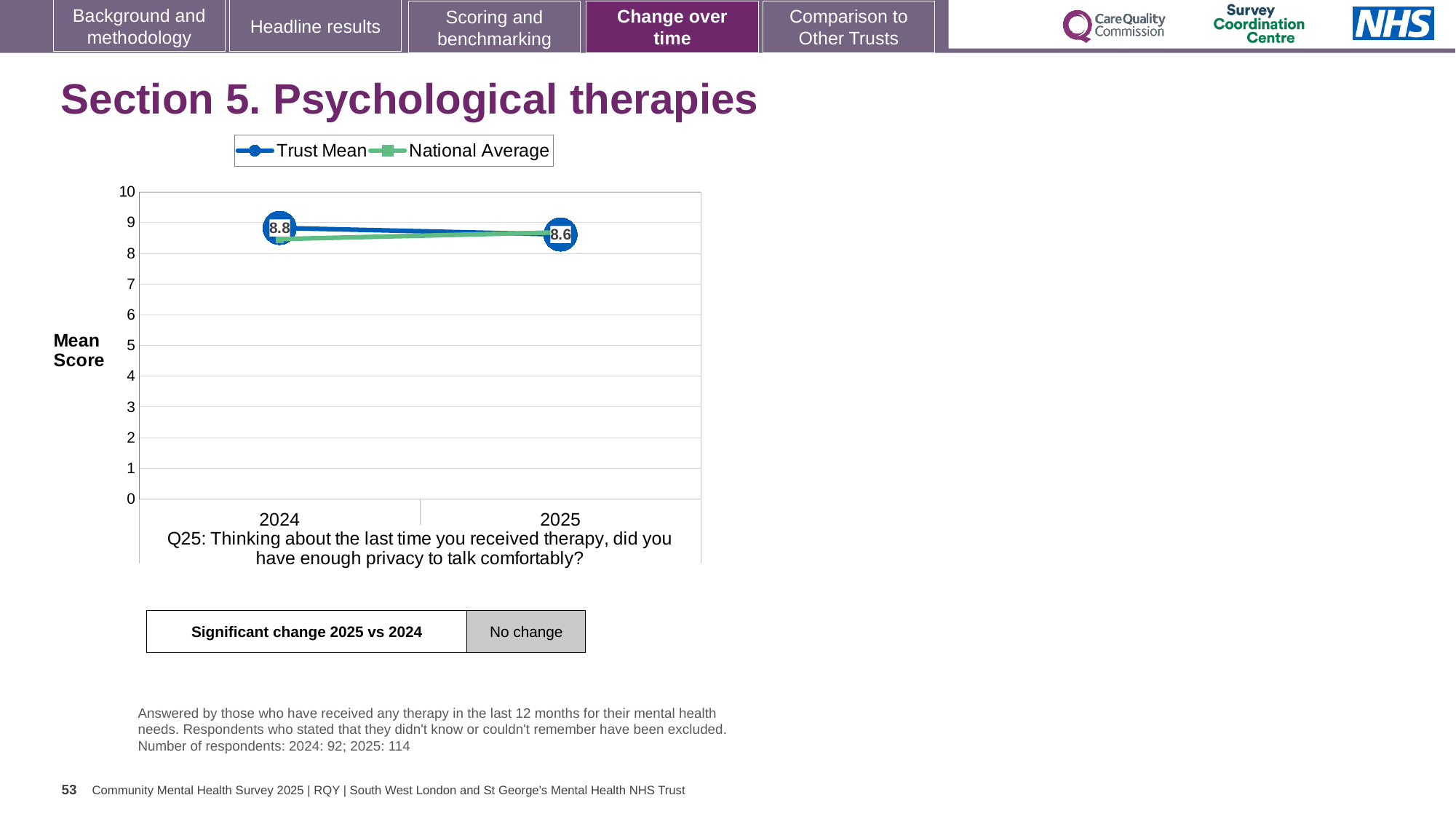
What is the Trust Mean value for 2025? 8.6 What kind of chart is shown on the slide? line chart What is the Trust Mean value for 2024? 8.8 Does the Trust Mean rise or fall from 2024 to 2025? fall What is the label on the y axis of the chart? Mean Score In which year is the Trust Mean lowest? 2025 What is the difference between the Trust Mean in 2024 and in 2025? 0.2 How many series does the legend list? 2 Is the National Average value for 2024 greater or less than 8? greater How many years are plotted on the x axis? 2 In 2024, which is larger: the Trust Mean or the National Average? Trust Mean In which year is the Trust Mean highest? 2024